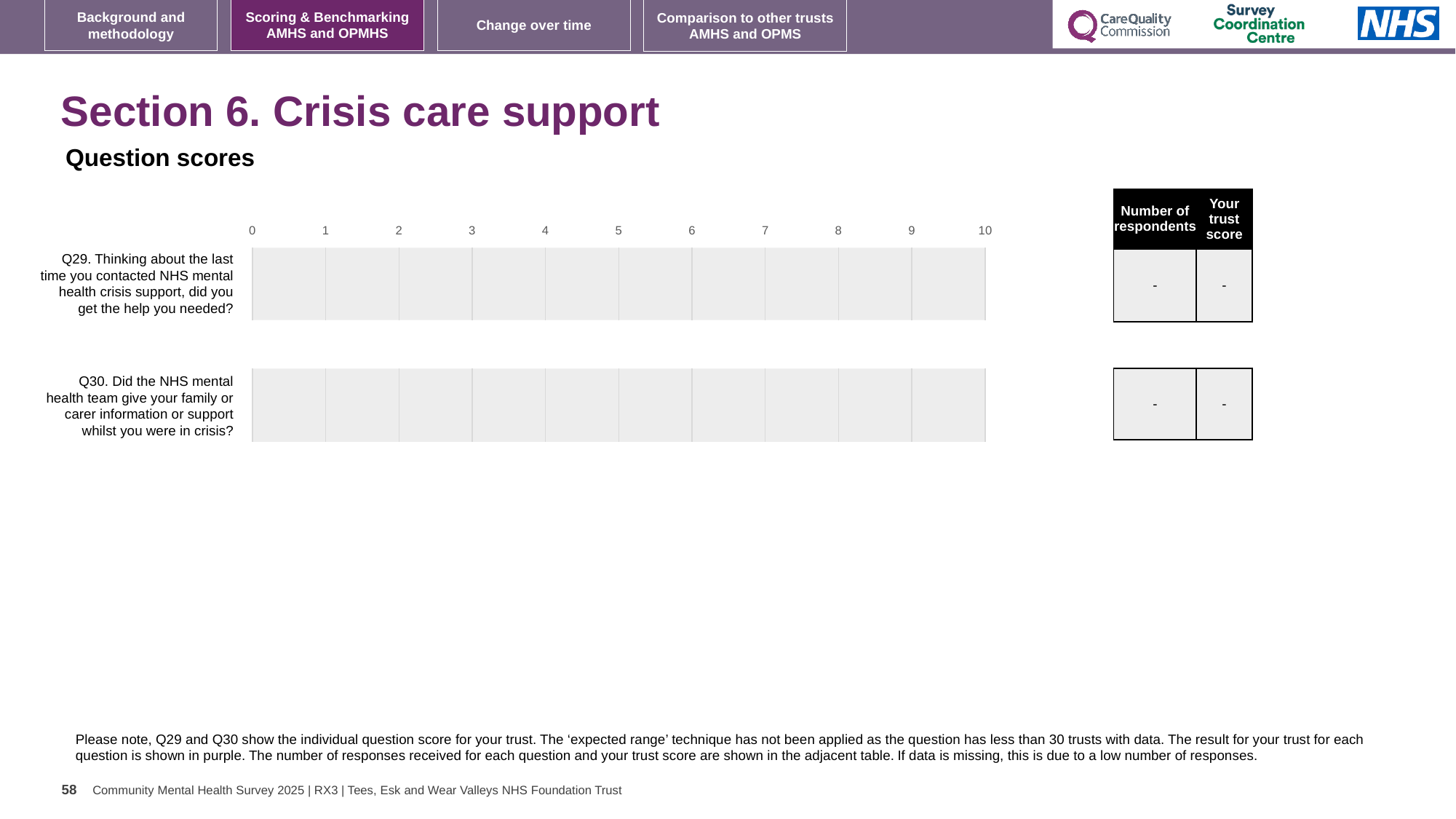
What is the 'Your trust score' shown for Q30 in the adjacent table? - What is the highest value shown on the chart's x axis? 10 Which question label appears first (at the top) on the chart? Q29 How many questions (categories) are listed on the chart? 2 What kind of chart is used on this slide? bar chart What is the 'Number of respondents' shown for Q29 in the adjacent table? -